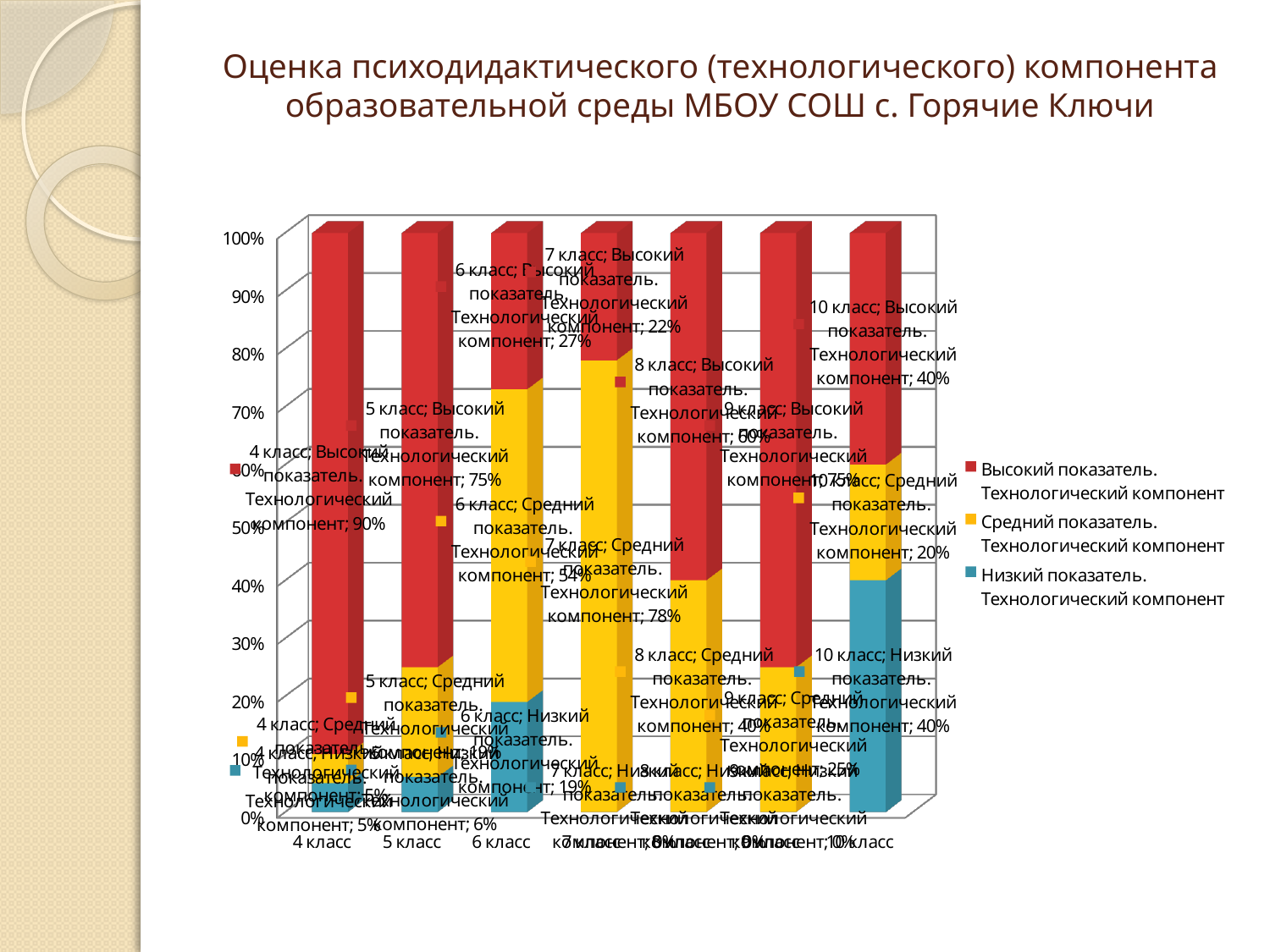
What is the value of 'Низкий показатель. Технологический компонент' for 10 класс? 40% Which colour represents 'Низкий показатель. Технологический компонент' in the legend? Teal (blue-green) What is the value of 'Высокий показатель. Технологический компонент' for 4 класс? 90% How many series does the legend list? 3 What is the difference between the 'Высокий показатель' values for 5 класс and 6 класс? 48% What is the value of 'Высокий показатель. Технологический компонент' for 8 класс? 60% Which is larger: the 'Средний показатель' value for 6 класс or for 9 класс? 6 класс What is the value of 'Средний показатель. Технологический компонент' for 7 класс? 78% Which class has the highest value for 'Высокий показатель. Технологический компонент'? 4 класс What kind of chart is shown on the slide? Stacked bar chart How many classes (categories) are shown on the x axis? 7 Which class has the lowest value for 'Высокий показатель. Технологический компонент'? 7 класс